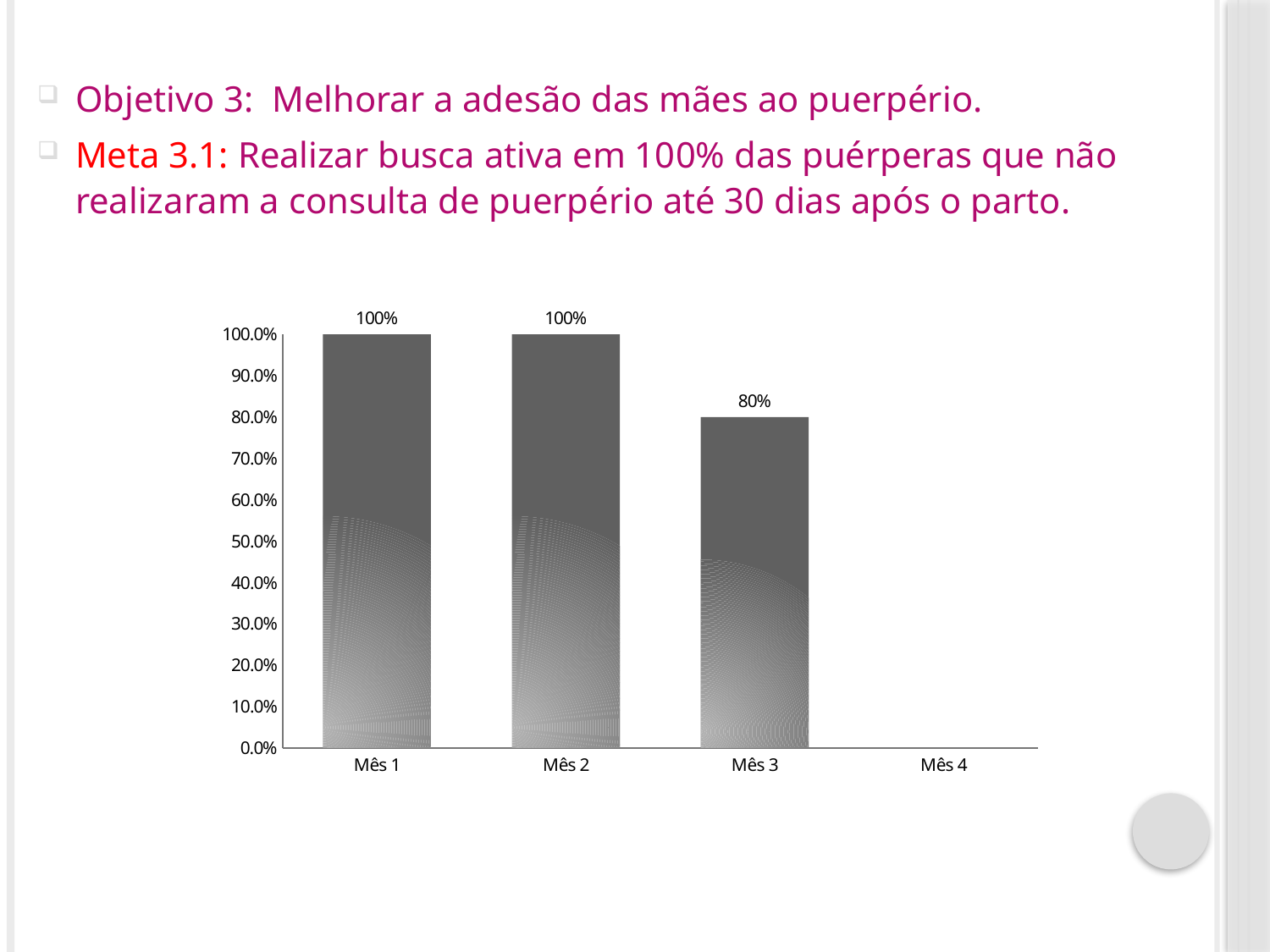
How many bars are actually plotted in the chart? 3 Which is larger, the value for Mês 2 or the value for Mês 3? Mês 2 What kind of chart is shown on the slide? bar chart What is the value shown for Mês 3? 80% Among the months with a bar plotted, which has the lowest value? Mês 3 What is the value shown for Mês 1? 100% What is the difference between the values for Mês 1 and Mês 3? 20 percentage points Is the value for Mês 3 greater or less than 90.0%? less How many categories are labelled on the x axis? 4 What is the value shown for Mês 2? 100% Does the value rise or fall from Mês 2 to Mês 3? fall Which months share the highest value in the chart? Mês 1 and Mês 2